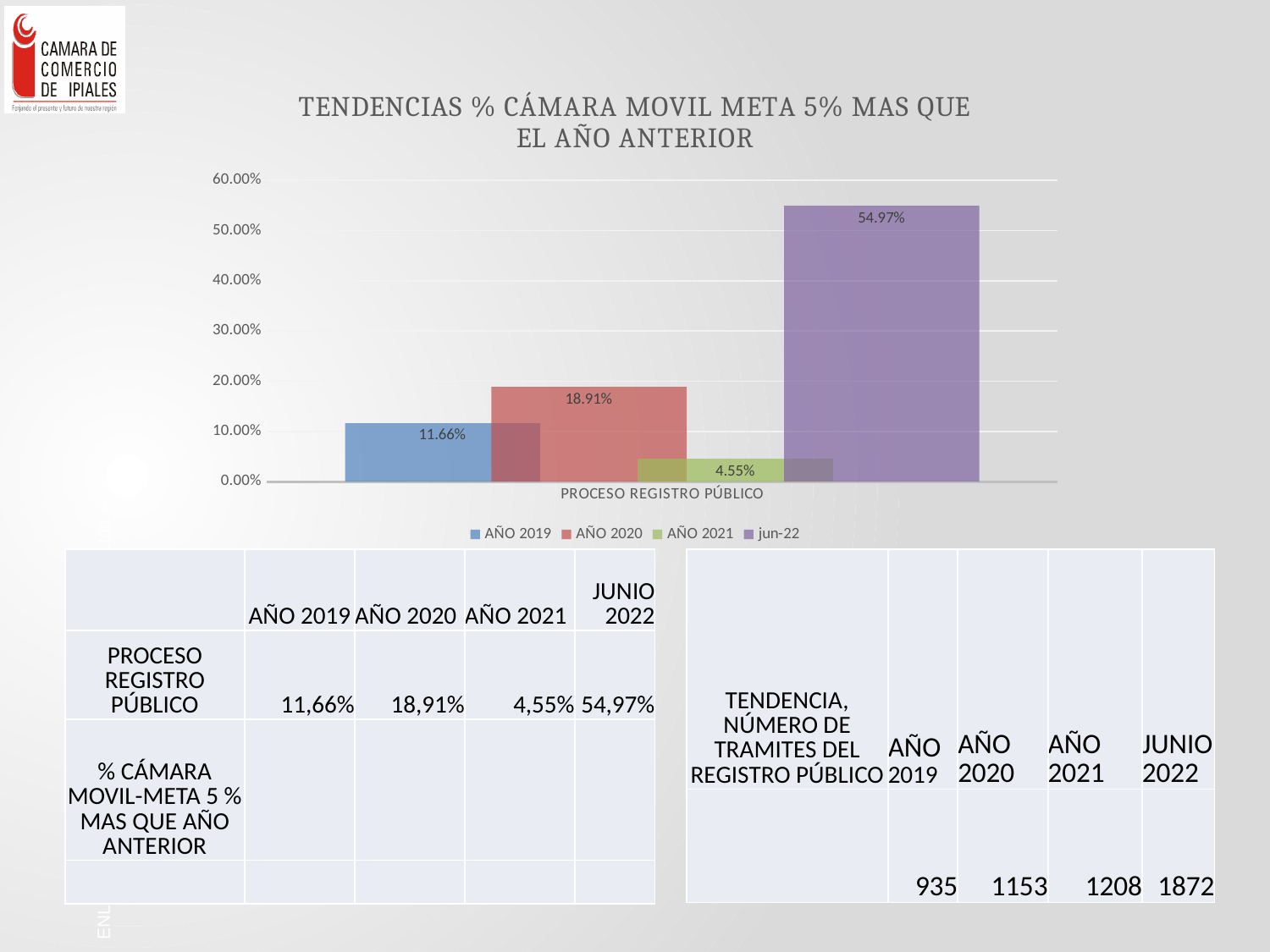
What is the value for AÑO 2021 in the chart? 4.55% Is the value for jun-22 greater or less than 50.00%? greater What kind of chart is shown on the slide? bar chart Which series has the highest value in the chart? jun-22 What is the value for AÑO 2019 in the chart? 11.66% What is the category label shown on the x axis of the chart? PROCESO REGISTRO PÚBLICO Which series has the lowest value in the chart? AÑO 2021 How many series does the legend list? 4 Which is larger, the value for AÑO 2019 or the value for AÑO 2020? AÑO 2020 What is the value for jun-22 in the chart? 54.97% What is the difference between the jun-22 value and the AÑO 2020 value? 36.06% What is the value for AÑO 2020 in the chart? 18.91%